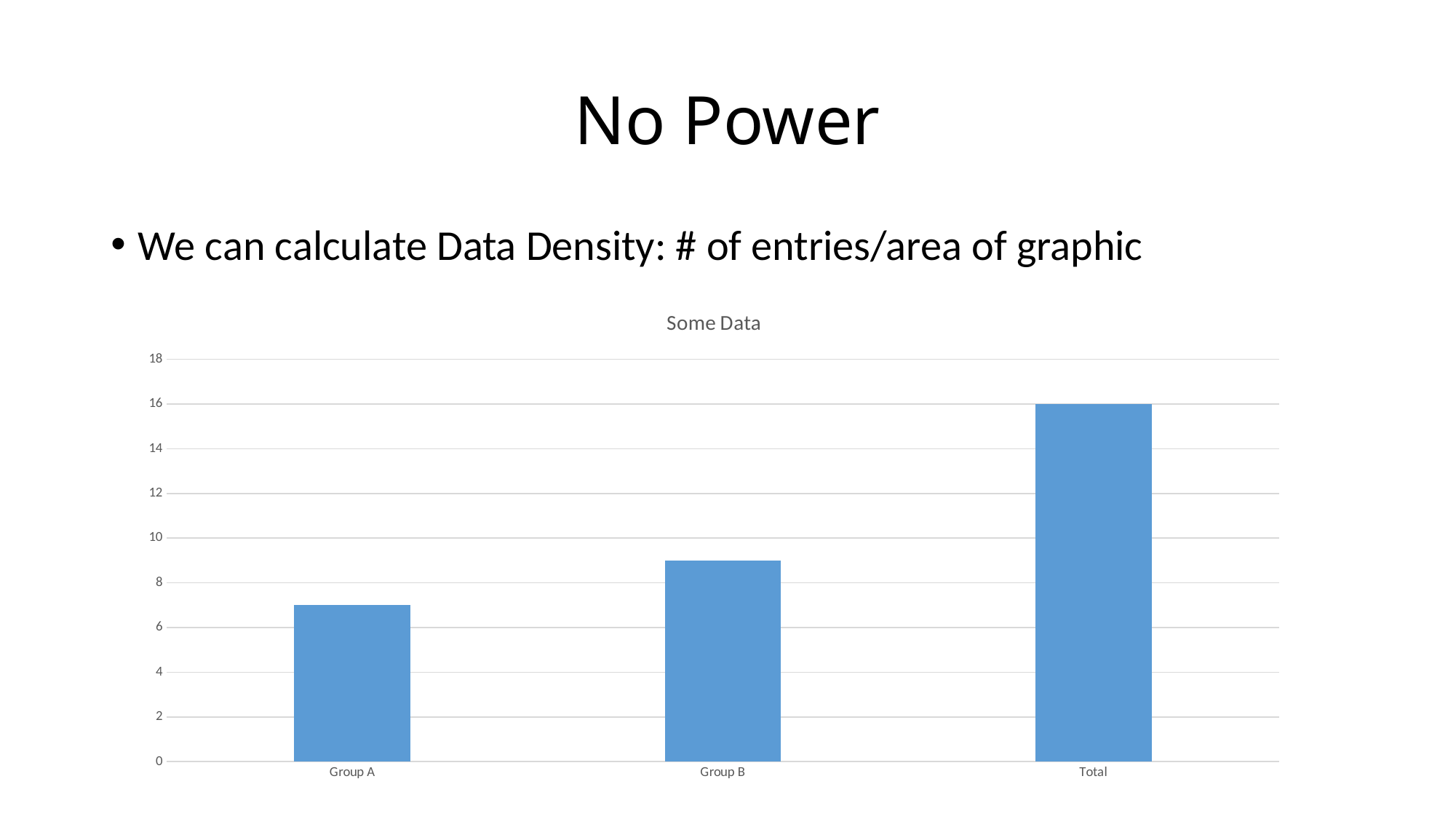
Is the value for Group A greater or less than 8? less How many categories are shown on the x axis? 3 Is the value for Group B greater or less than 10? less What is the value for Total? 16 Is the value for Total greater or less than 14? greater Which category has the highest value? Total Which is larger, the value for Group A or the value for Group B? Group B Which category has the lowest value? Group A What kind of chart is shown on the slide? bar chart What is the title of the chart? Some Data